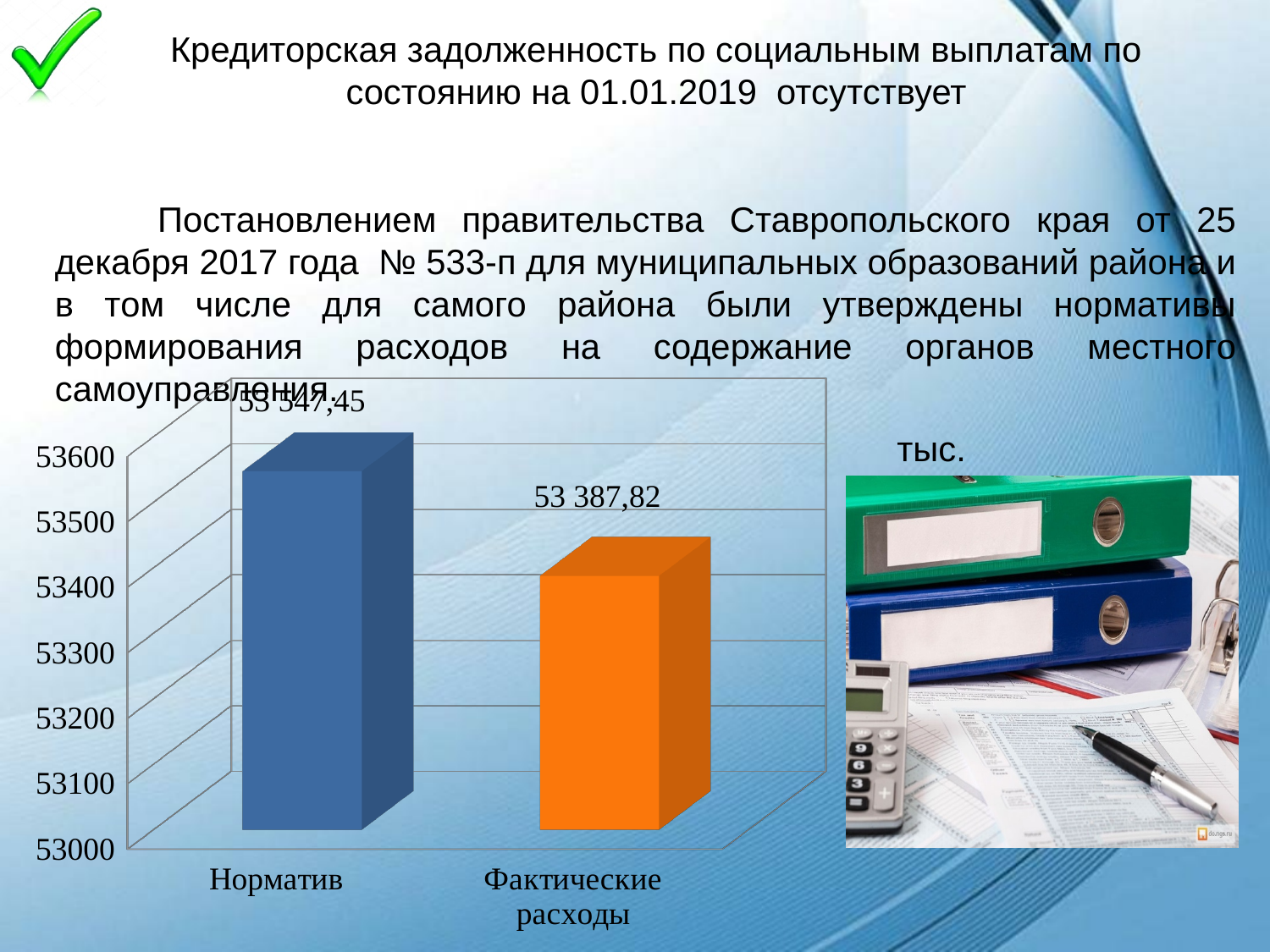
Which category has the highest value? Норматив What kind of chart is shown on the slide? bar chart What is the value for Фактические расходы? 53 387,82 Which category has the lowest value? Фактические расходы Is the value for Фактические расходы greater or less than 53300? greater What colour is the bar for Фактические расходы? orange Which is larger, the value for Норматив or the value for Фактические расходы? Норматив Is the value for Норматив greater or less than 53500? greater What is the lowest value shown on the vertical axis of the chart? 53000 How many categories are shown on the chart? 2 What is the difference between the values for Норматив and Фактические расходы? 159,63 What is the value for Норматив? 53 547,45